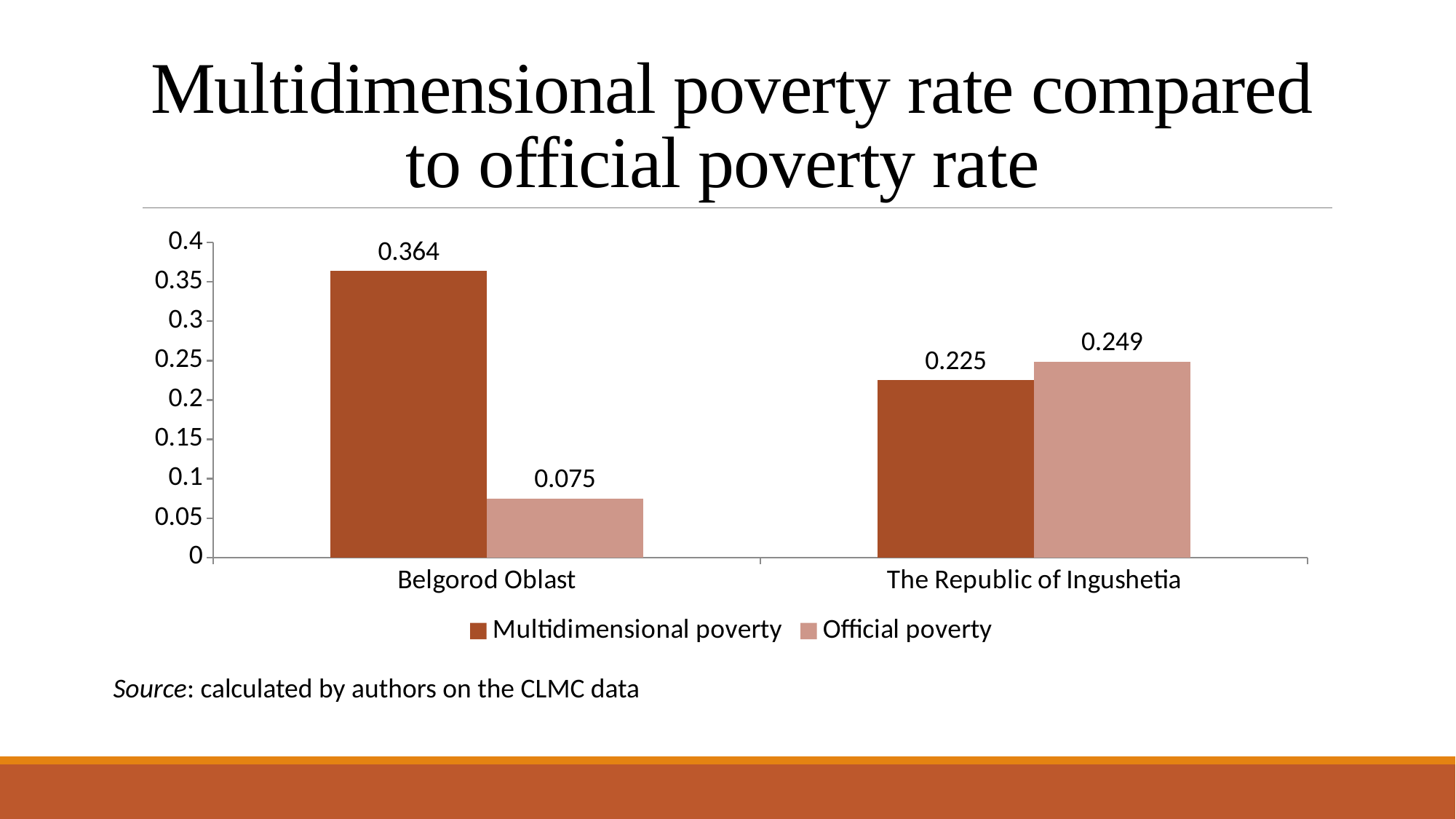
Which region has the lower official poverty rate? Belgorod Oblast How many series does the legend list? 2 What is the multidimensional poverty rate for The Republic of Ingushetia? 0.225 For The Republic of Ingushetia, which is larger: the multidimensional poverty rate or the official poverty rate? Official poverty What is the difference between the multidimensional and official poverty rates for Belgorod Oblast? 0.289 What kind of chart is shown on the slide? Bar chart Which region has the higher multidimensional poverty rate? Belgorod Oblast What is the official poverty rate for The Republic of Ingushetia? 0.249 What is the official poverty rate for Belgorod Oblast? 0.075 What is the multidimensional poverty rate for Belgorod Oblast? 0.364 What is the difference between the official and multidimensional poverty rates for The Republic of Ingushetia? 0.024 How many regions are shown on the x axis? 2